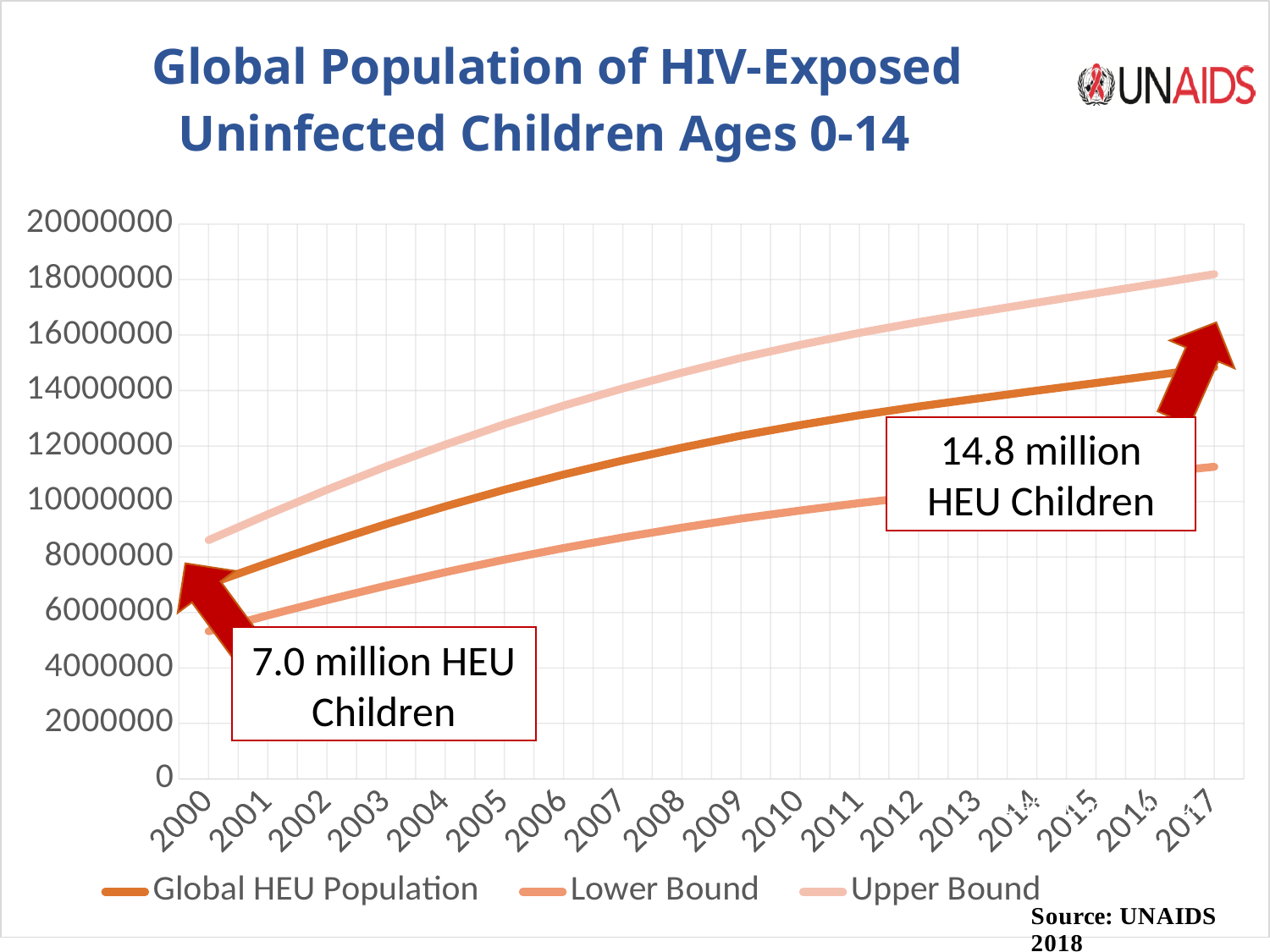
What are the three series listed in the legend? Global HEU Population, Lower Bound, Upper Bound What is the Global HEU Population in 2000, as labelled on the chart? 7.0 million Does the Global HEU Population rise or fall from 2000 to 2017? rise Is the Lower Bound value for 2017 greater or less than 12000000? less Is the Lower Bound value for 2000 greater or less than 6000000? less In which year is the Global HEU Population highest? 2017 How many series does the legend list? 3 What kind of chart is shown on the slide? line chart How many years are shown on the x axis? 18 By how much did the Global HEU Population grow between 2000 and 2017, according to the labels? 7.8 million What is the Global HEU Population in 2017, as labelled on the chart? 14.8 million Is the Upper Bound value for 2017 greater or less than 16000000? greater